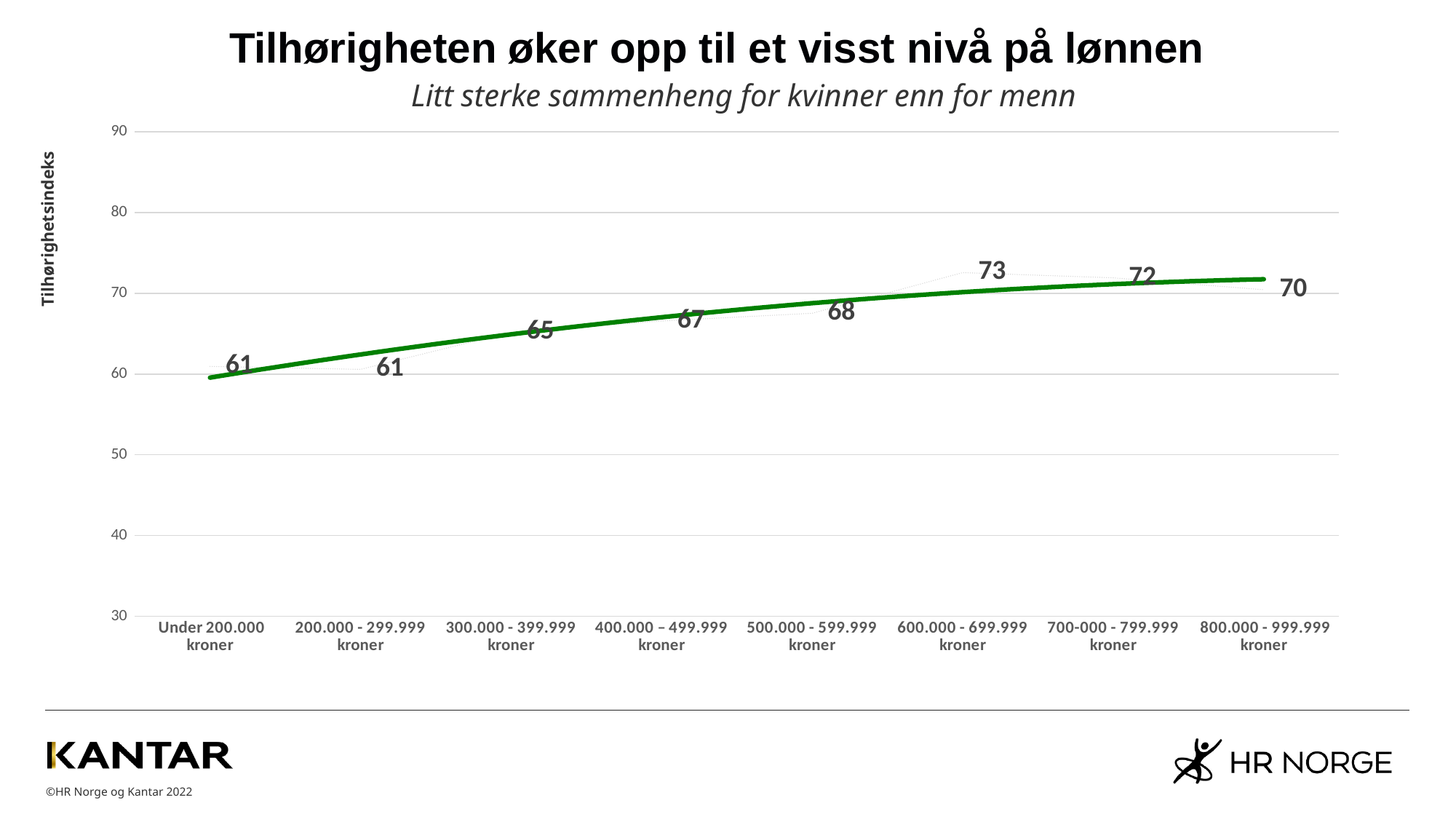
How many salary categories are shown on the x axis? 8 What is the Tilhørighetsindeks value for the Under 200.000 kroner category? 61 Which has a higher Tilhørighetsindeks value: 500.000 - 599.999 kroner or 700-000 - 799.999 kroner? 700-000 - 799.999 kroner What is the difference between the Tilhørighetsindeks values for 600.000 - 699.999 kroner and Under 200.000 kroner? 12 What kind of chart is shown on the slide? line chart What is the Tilhørighetsindeks value for the 600.000 - 699.999 kroner category? 73 What is the Tilhørighetsindeks value for the 300.000 - 399.999 kroner category? 65 Do the Tilhørighetsindeks values generally rise or fall from Under 200.000 kroner to 600.000 - 699.999 kroner? rise What is the Tilhørighetsindeks value for the 800.000 - 999.999 kroner category? 70 Which salary category has the highest Tilhørighetsindeks value? 600.000 - 699.999 kroner What is the label of the y axis? Tilhørighetsindeks Is the Tilhørighetsindeks value for 400.000 – 499.999 kroner greater or less than 60? greater